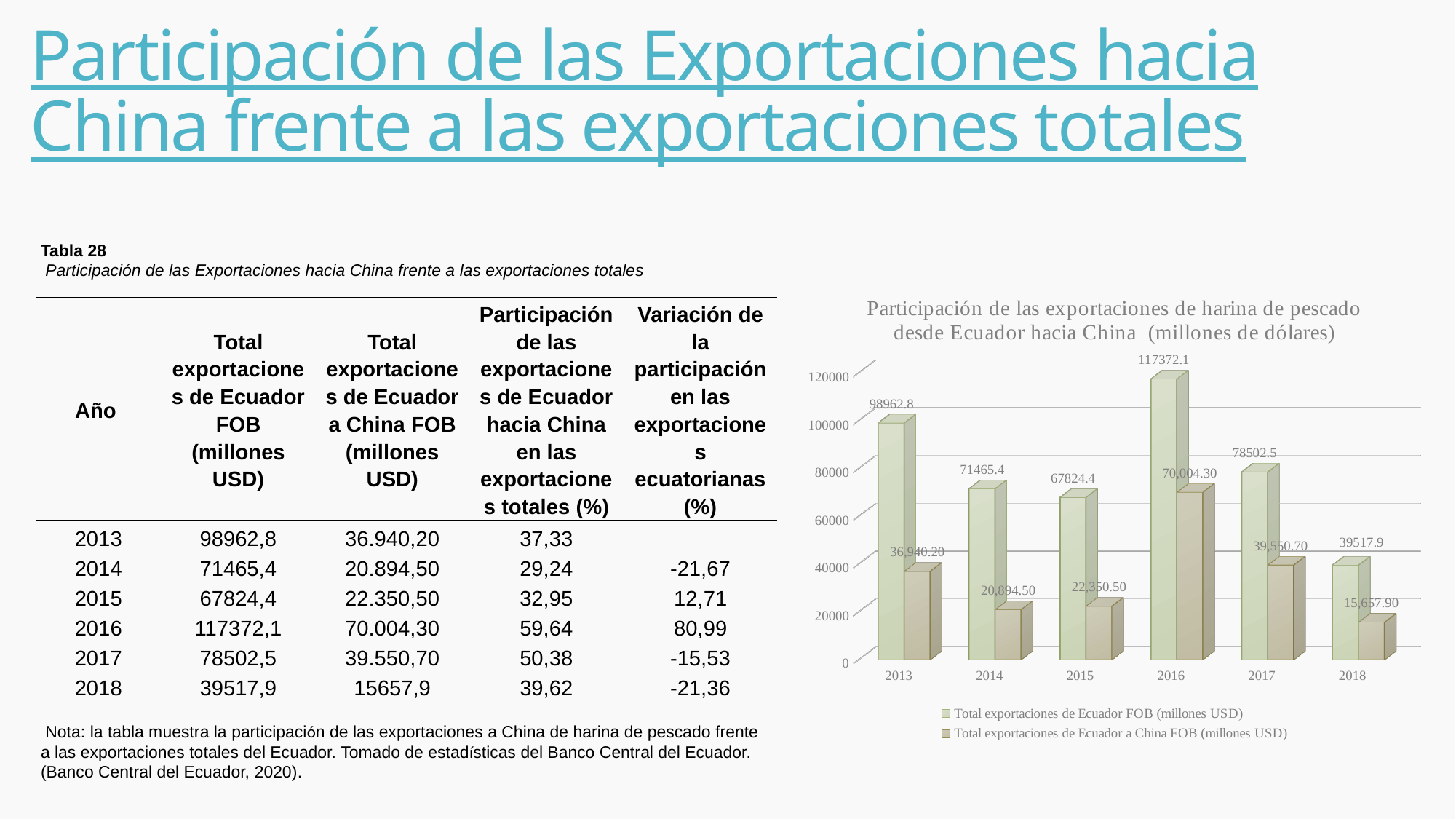
How many series does the chart legend list? 2 What is the value of Total exportaciones de Ecuador a China FOB for 2018 in the chart? 15,657.90 What is the difference between Total exportaciones de Ecuador FOB in 2016 and in 2013 in the chart? 18409.3 What type of chart is shown on the slide? bar chart What is the title of the chart on the slide? Participación de las exportaciones de harina de pescado desde Ecuador hacia China (millones de dólares) How many years are shown on the x axis of the chart? 6 In which year is Total exportaciones de Ecuador a China FOB lowest in the chart? 2018 In which year is Total exportaciones de Ecuador FOB highest in the chart? 2016 Is the value of Total exportaciones de Ecuador FOB for 2017 greater or less than 60000? greater Which is larger in the chart: Total exportaciones de Ecuador a China FOB in 2015 or in 2014? 2015 What is the value of Total exportaciones de Ecuador FOB for 2016 in the chart? 117372.1 What is the value of Total exportaciones de Ecuador a China FOB for 2014 in the chart? 20,894.50